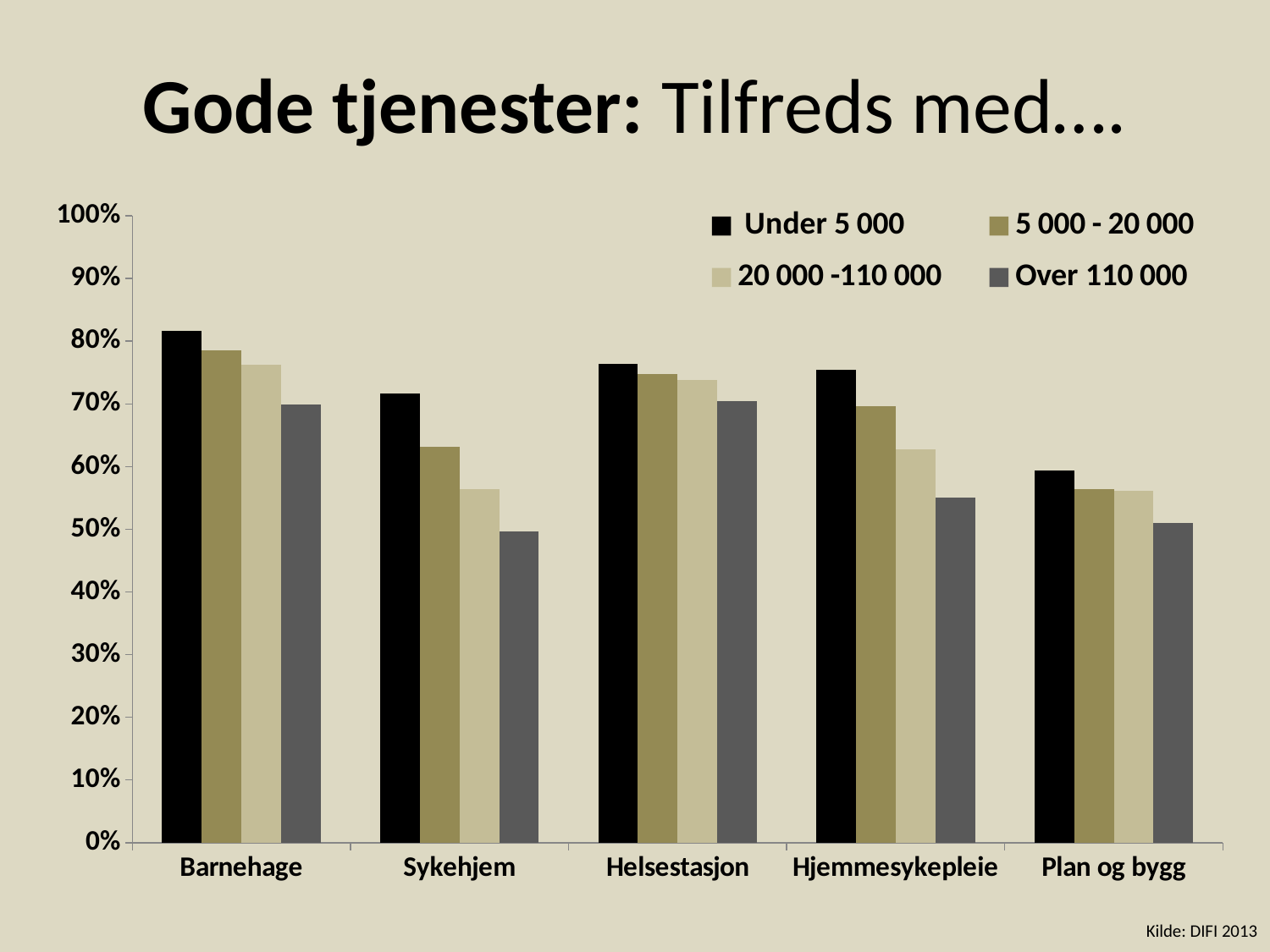
Is the value for Helsestasjon in the 'Under 5 000' series greater or less than 70%? greater How many service categories are shown along the x axis? 5 For the 'Under 5 000' series, which category has the lowest value? Plan og bygg Within the Hjemmesykepleie category, which series has the lowest value? Over 110 000 Within the Sykehjem category, do the values rise or fall going from the 'Under 5 000' series to the 'Over 110 000' series? Fall Is the value for Hjemmesykepleie in the 'Over 110 000' series greater or less than 50%? greater How many series does the legend list? 4 For Hjemmesykepleie, which is larger: the '5 000 - 20 000' value or the '20 000 -110 000' value? 5 000 - 20 000 What type of chart is shown on the slide? Bar chart Is the value for Sykehjem in the '5 000 - 20 000' series greater or less than 60%? greater For the 'Under 5 000' series, which category has the highest value? Barnehage Within the Sykehjem category, which series has the highest value? Under 5 000